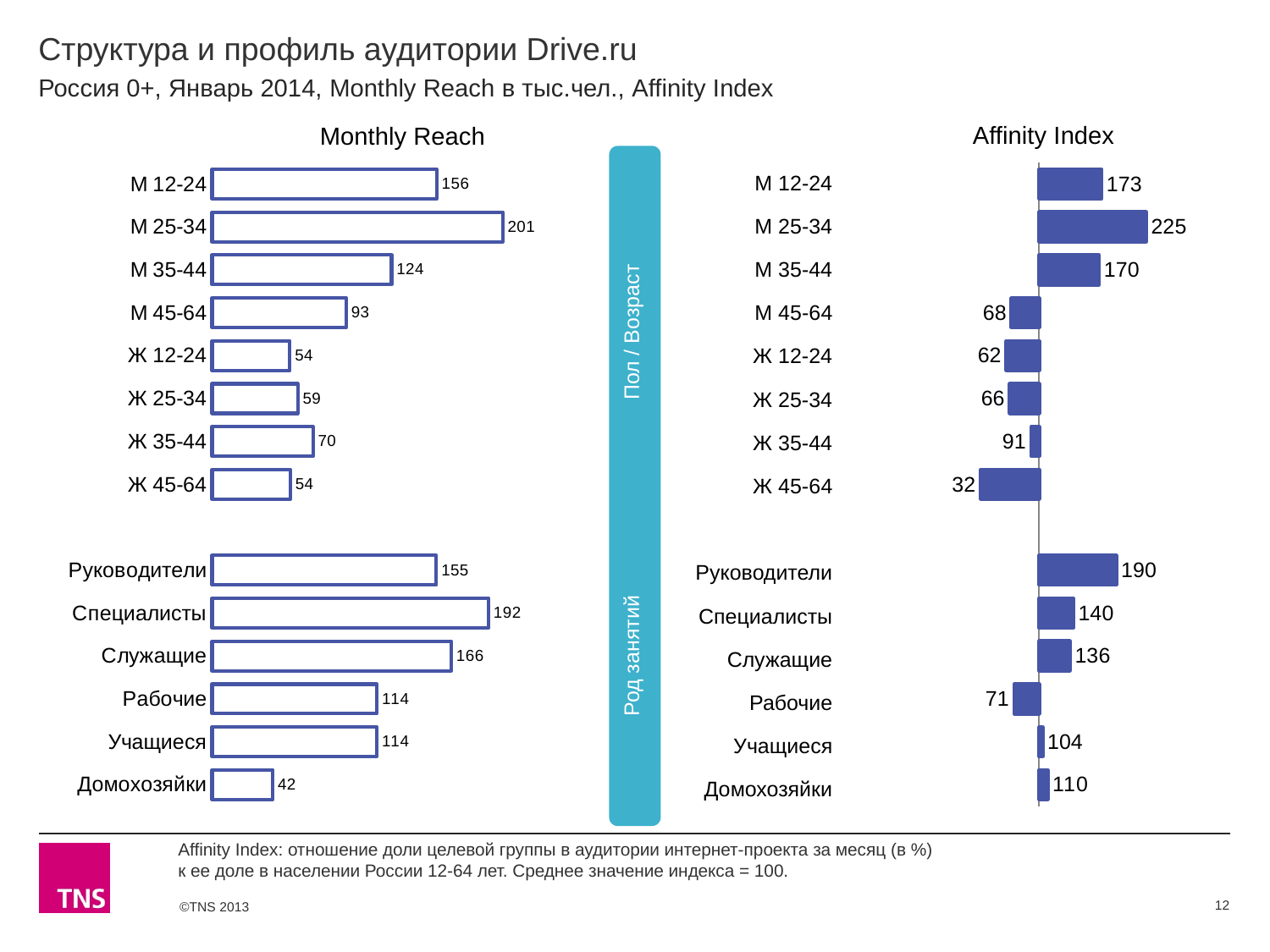
In the Affinity Index chart, what is the difference between М 12-24 and М 35-44? 3 What type of chart is the Affinity Index chart? Bar chart What are the two group labels shown on the vertical band between the charts? Пол / Возраст and Род занятий In the Monthly Reach chart, what is the value for М 25-34? 201 In the Affinity Index chart, what is the value for Учащиеся? 104 In the Monthly Reach chart, what is the value for Ж 35-44? 70 In the Monthly Reach chart, what is the difference between Специалисты and Руководители? 37 In the Affinity Index chart, which is larger: Руководители or Специалисты? Руководители In the Monthly Reach chart, how many categories are plotted? 14 In the Monthly Reach chart, which category has the lowest value? Домохозяйки In the Affinity Index chart, which category has the highest value? М 25-34 In the Affinity Index chart, what is the value for Ж 45-64? 32